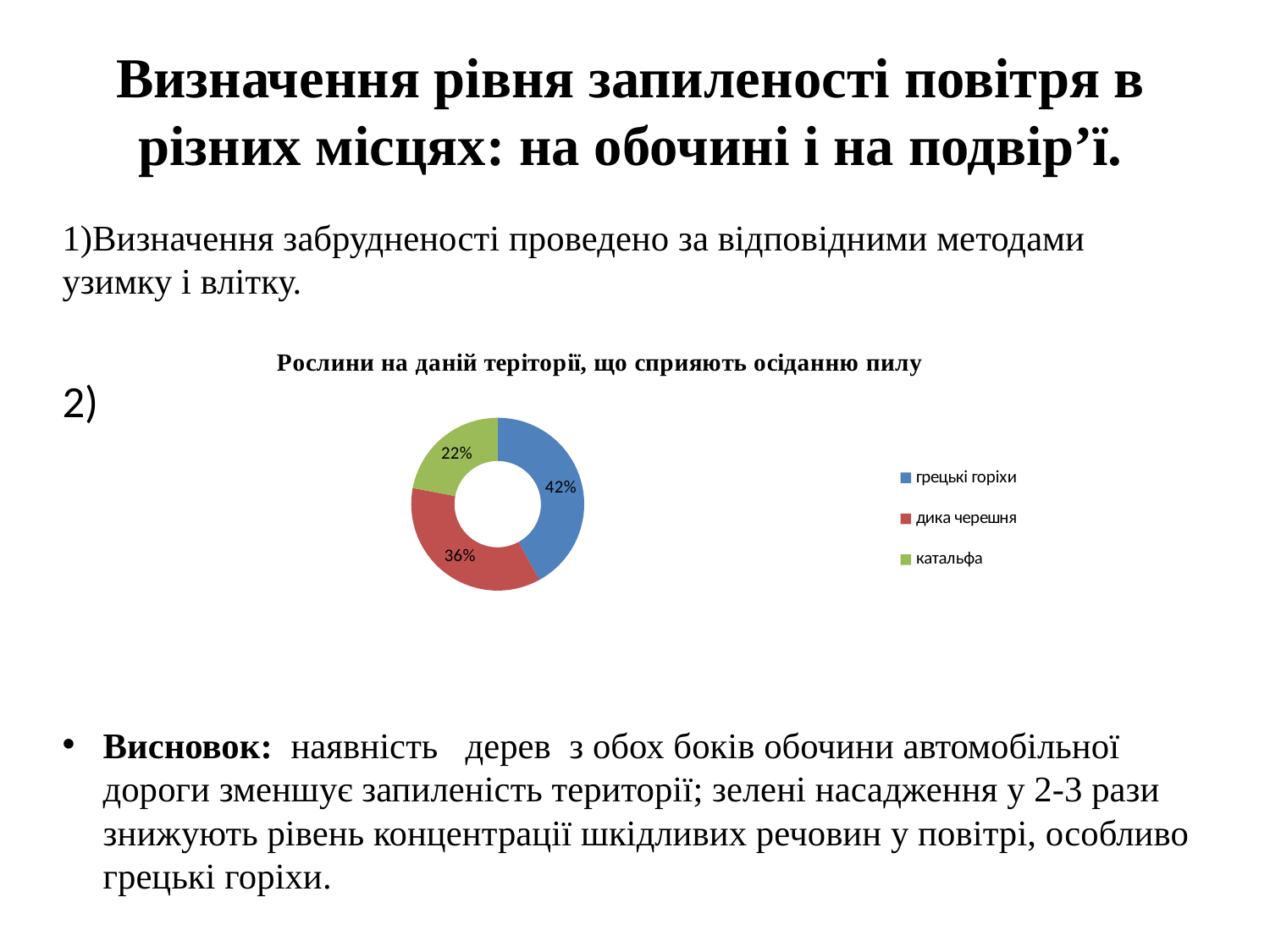
Which is larger, the share for дика черешня or the share for катальфа? дика черешня What is the title of the chart? Рослини на даній теріторії, що сприяють осіданню пилу What share of the chart does катальфа take? 22% What share of the chart does дика черешня take? 36% How many categories does the chart show? 3 Which category has the largest share? грецькі горіхи What kind of chart is shown on the slide? doughnut (pie) chart What colour is the slice for катальфа? green What share of the chart does грецькі горіхи take? 42% What is the difference in percentage points between дика черешня and катальфа? 14% What is the difference in percentage points between грецькі горіхи and катальфа? 20% Which category has the smallest share? катальфа